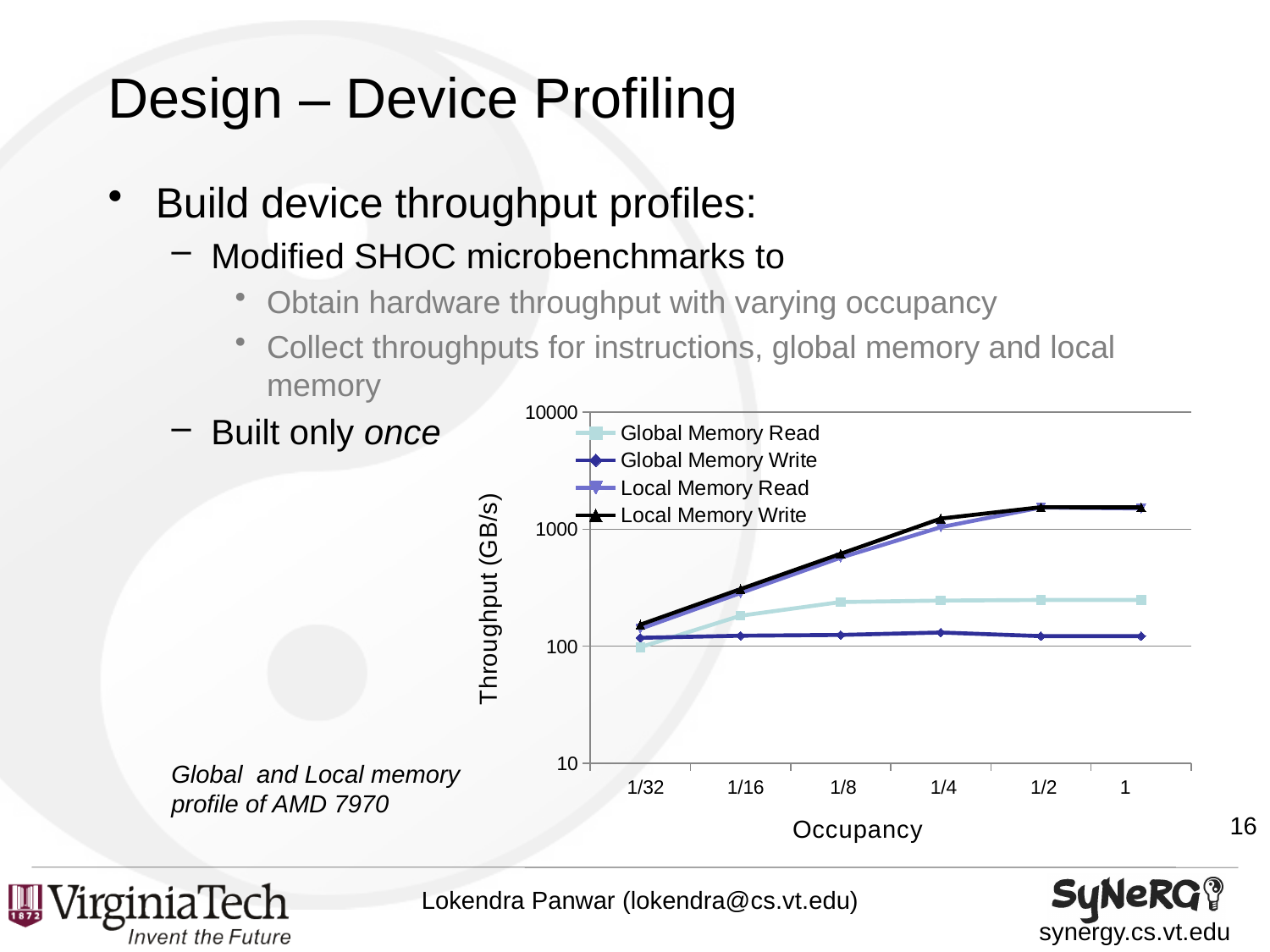
Is the Local Memory Write throughput at occupancy 1/32 greater or less than 1000? less What is the label of the y axis? Throughput (GB/s) Does the Local Memory Write throughput rise or fall as occupancy increases from 1/32 to 1/2? rise What is the label of the x axis? Occupancy Is the Global Memory Write throughput at occupancy 1 greater or less than 1000? less Is the Local Memory Write throughput at occupancy 1 greater or less than 1000? greater How many occupancy values are shown along the x axis? 6 Which series has the lowest throughput at occupancy 1? Global Memory Write What kind of chart is shown on the slide? line chart How many series does the chart legend list? 4 At occupancy 1, which is larger: Local Memory Write throughput or Global Memory Read throughput? Local Memory Write